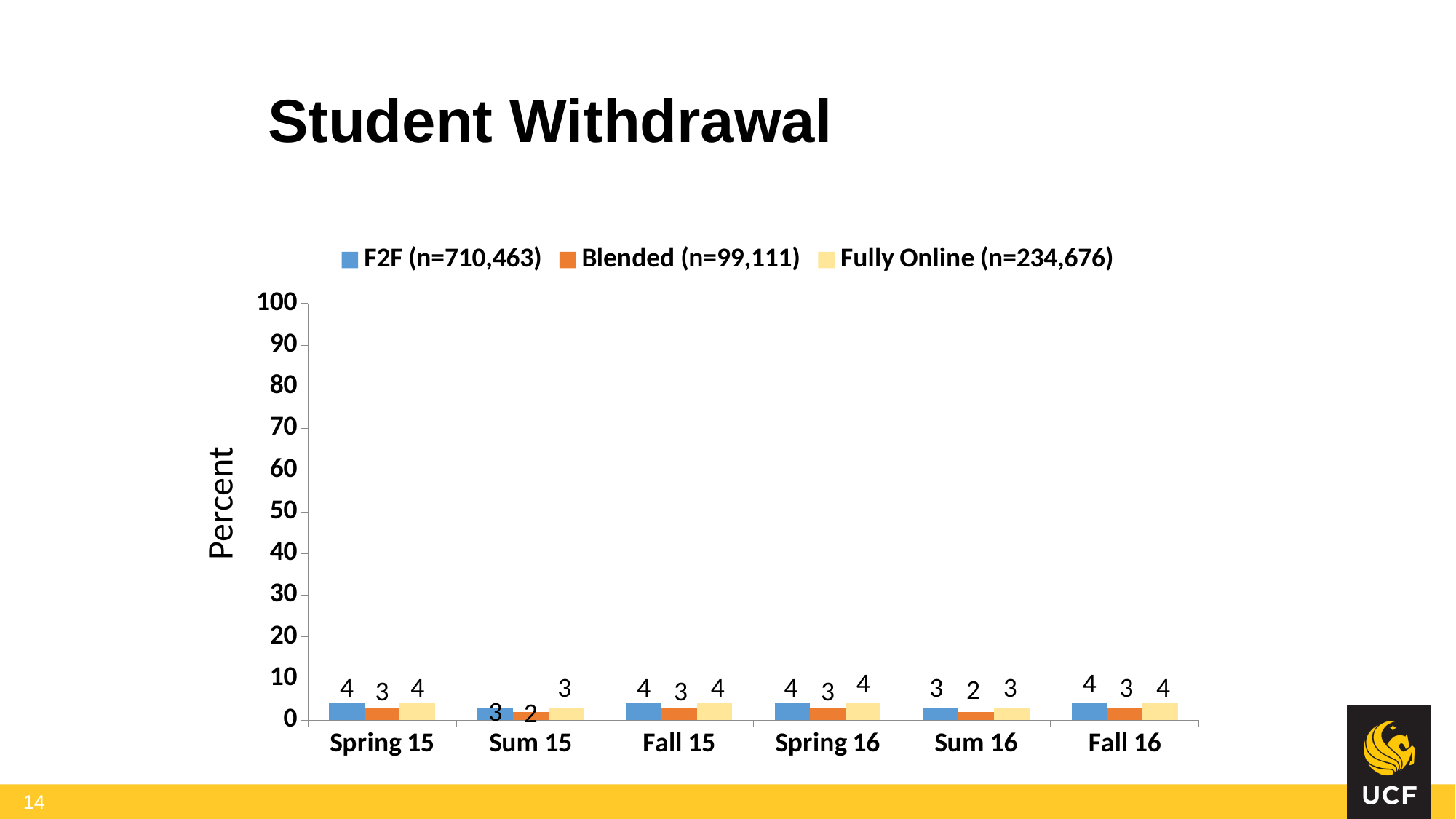
What is the value for Blended in Sum 15? 2 Is the value for Fully Online in Spring 16 greater or less than 10? less Which series has the lowest value in Sum 16? Blended How many series does the legend list? 3 What is the label of the y axis? Percent What is the value for Blended in Spring 16? 3 What kind of chart is shown on the slide? bar chart What is the withdrawal percentage for F2F in Spring 15? 4 What is the value for Fully Online in Fall 16? 4 How many terms are shown on the x axis? 6 Which is larger, the F2F value in Spring 15 or the F2F value in Sum 15? F2F in Spring 15 What is the difference between the F2F and Blended values in Fall 15? 1